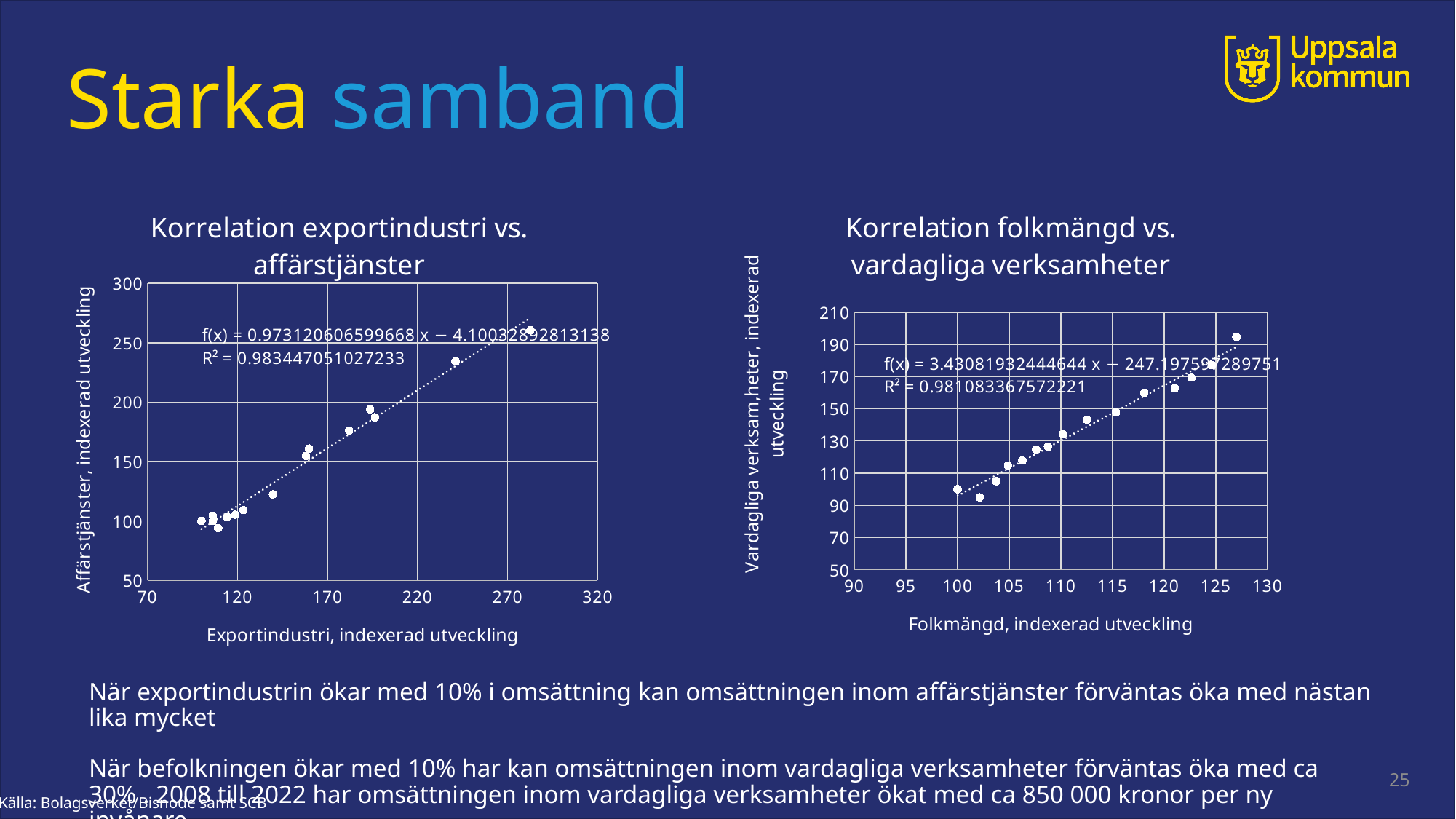
What is the y-axis title of the left chart, 'Korrelation exportindustri vs. affärstjänster'? Affärstjänster, indexerad utveckling In the right chart, 'Korrelation folkmängd vs. vardagliga verksamheter', is the y-value of the lowest point greater or less than 100? less What is the x-axis title of the right chart, 'Korrelation folkmängd vs. vardagliga verksamheter'? Folkmängd, indexerad utveckling In the left chart, 'Korrelation exportindustri vs. affärstjänster', what R² value is printed on the chart? 0.983447051027233 In the left chart, 'Korrelation exportindustri vs. affärstjänster', is the y-value of the leftmost point greater or less than 150? less In the left chart, 'Korrelation exportindustri vs. affärstjänster', do the plotted values rise or fall as the x-axis value increases? rise What kind of chart is the right chart, 'Korrelation folkmängd vs. vardagliga verksamheter'? scatter chart In the left chart, 'Korrelation exportindustri vs. affärstjänster', is the y-value of the rightmost point greater or less than 250? greater In the right chart, 'Korrelation folkmängd vs. vardagliga verksamheter', do the plotted values rise or fall as the x-axis value increases? rise In the right chart, 'Korrelation folkmängd vs. vardagliga verksamheter', what R² value is printed on the chart? 0.981083367572221 What kind of chart is the left chart, 'Korrelation exportindustri vs. affärstjänster'? scatter chart